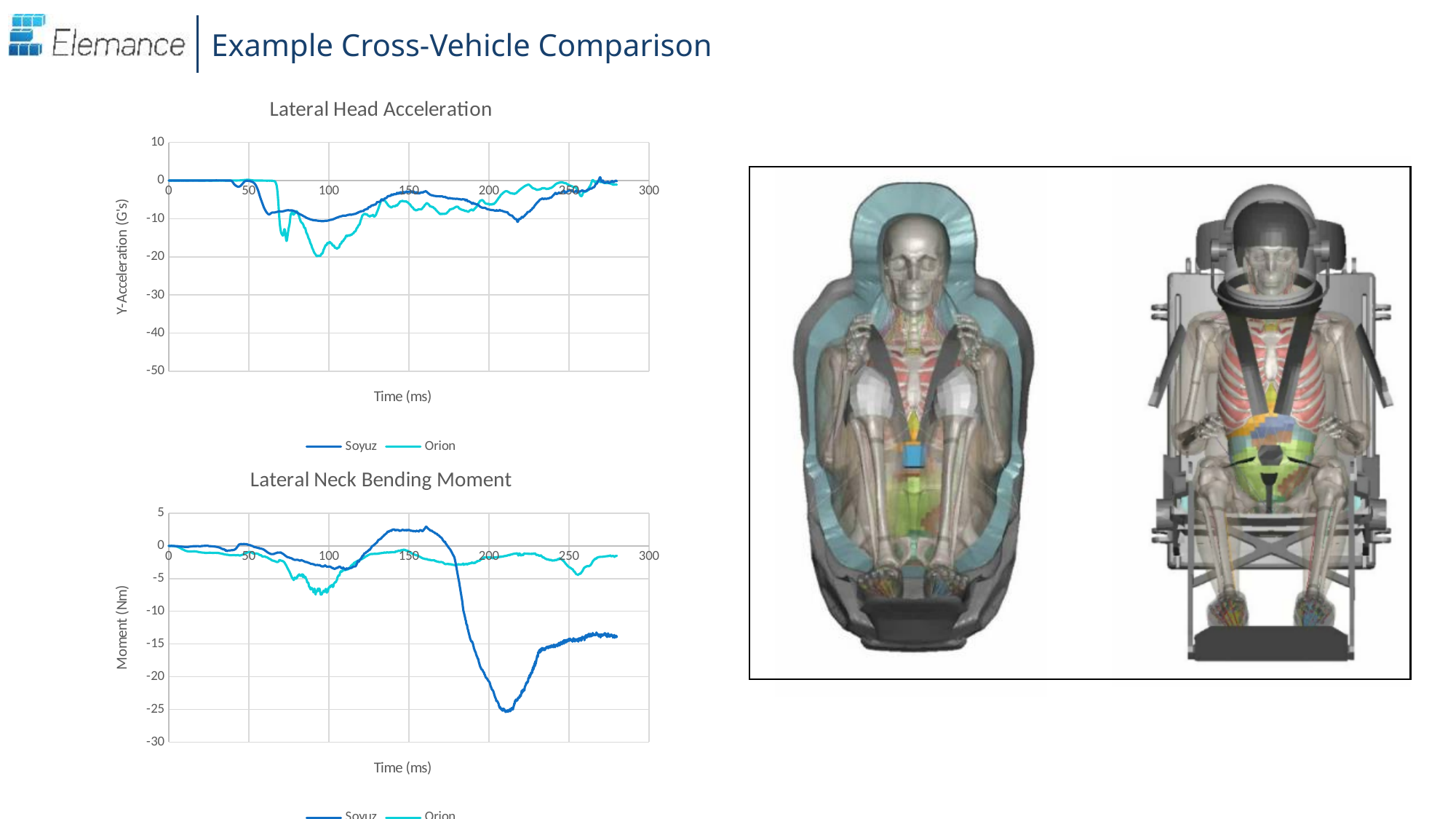
In the "Lateral Neck Bending Moment" chart, which series reaches the lowest (most negative) moment value? Soyuz What is the y-axis label of the "Lateral Neck Bending Moment" chart? Moment (Nm) Which two series are shown in the "Lateral Neck Bending Moment" chart? Soyuz and Orion In the "Lateral Neck Bending Moment" chart, is the minimum value of the Soyuz series greater or less than -20? less How many series does the legend of the "Lateral Head Acceleration" chart list? 2 In the "Lateral Neck Bending Moment" chart, is the minimum value of the Orion series greater or less than -5? less In the "Lateral Head Acceleration" chart, is the minimum value of the Orion series greater or less than -10? less In the "Lateral Head Acceleration" chart, which series reaches the lowest (most negative) acceleration value? Orion What type of chart is the "Lateral Head Acceleration" chart? line chart